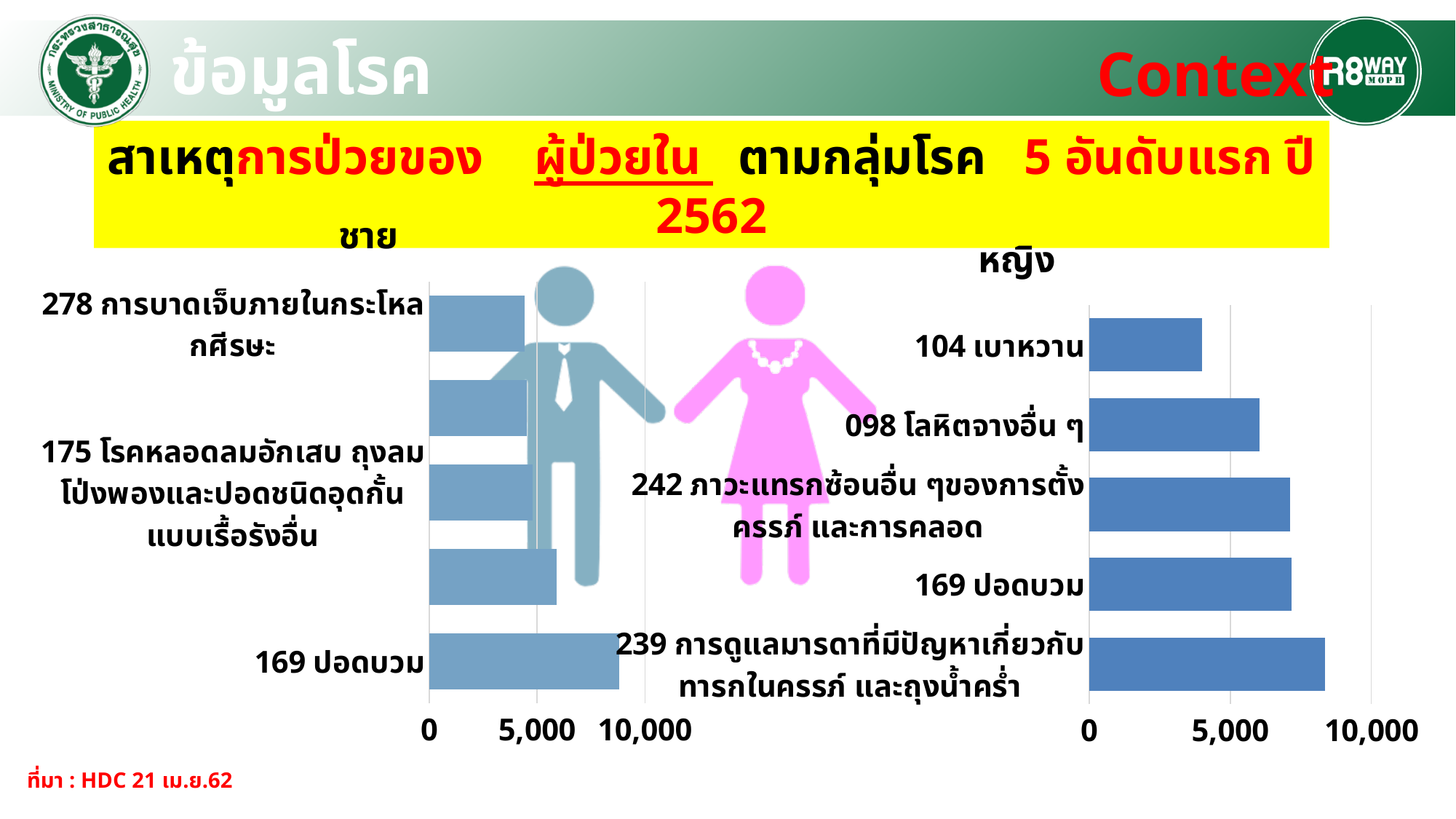
In the หญิง chart on the right, which is larger: the value for 098 โลหิตจางอื่น ๆ or the value for 104 เบาหวาน? 098 โลหิตจางอื่น ๆ In the หญิง chart on the right, is the value for 098 โลหิตจางอื่น ๆ greater or less than 5,000? greater In the หญิง chart on the right, which disease group has the shortest bar? 104 เบาหวาน In the หญิง chart on the right, is the value for 104 เบาหวาน greater or less than 5,000? less How many bars are in the หญิง (female) chart on the right? 5 What kind of chart is used for the ชาย (male) data on the left? Bar chart In the ชาย chart on the left, is the value for 169 ปอดบวม greater or less than 5,000? greater What data source is cited at the bottom of the slide? HDC 21 เม.ย.62 In the หญิง chart on the right, which disease group has the longest bar? 239 การดูแลมารดาที่มีปัญหาเกี่ยวกับทารกในครรภ์ และถุงน้ำคร่ำ What is the highest tick value shown on the x axis of the ชาย chart? 10,000 In the ชาย chart on the left, which disease group has the longest bar? 169 ปอดบวม